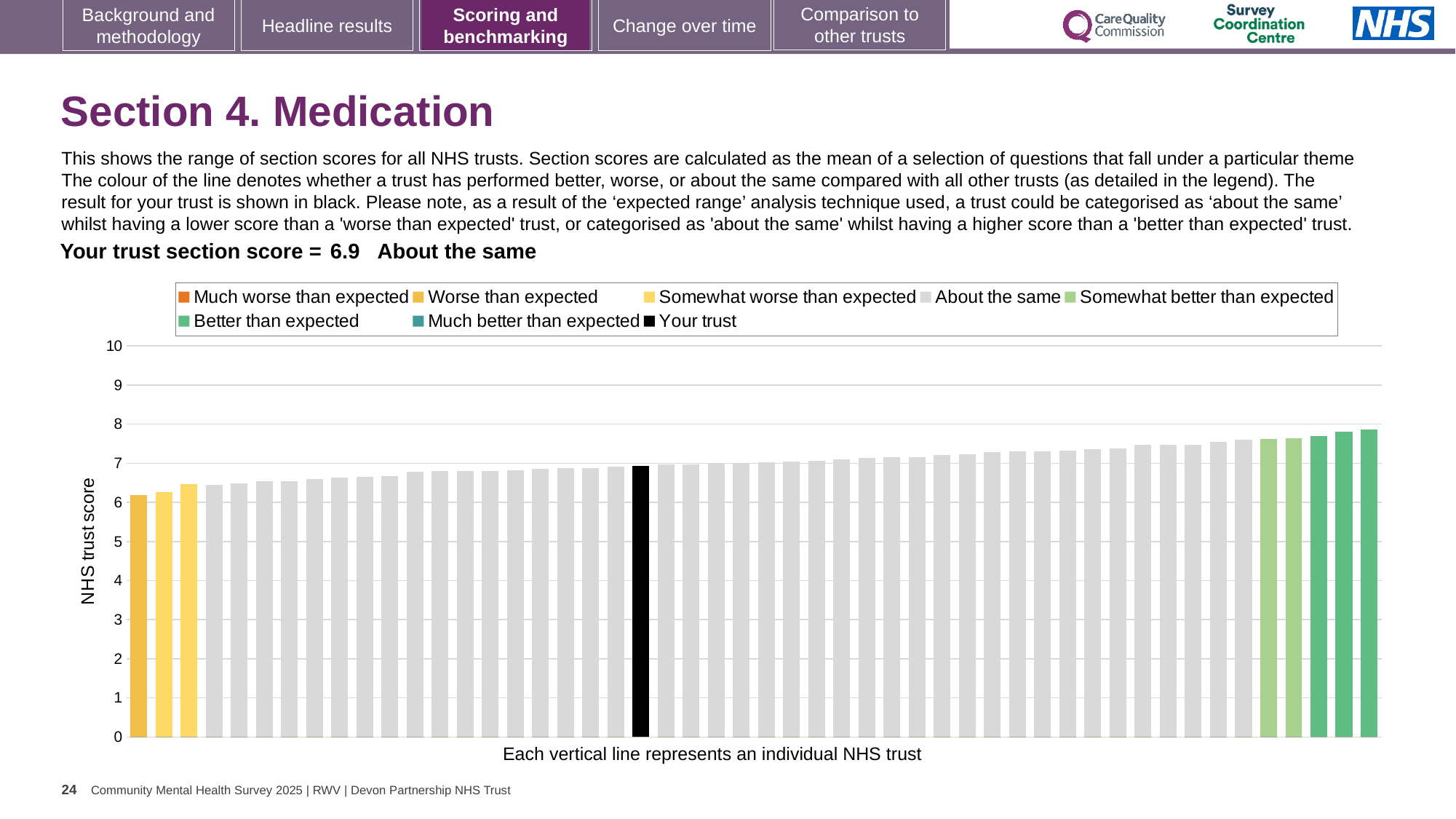
Do the bar values rise or fall from left to right along the x axis? rise Is the value of the shortest bar greater or less than 6? greater Is the value of the tallest bar greater or less than 7? greater Which category is your trust placed in according to the text above the chart? About the same What kind of chart is shown on the slide? bar chart How many bars are coloured black on the chart? 1 Is the value of the black bar for your trust greater or less than 6? greater How many entries does the chart legend list? 8 What is the section score for your trust shown on the slide? 6.9 What is the title of the vertical axis? NHS trust score